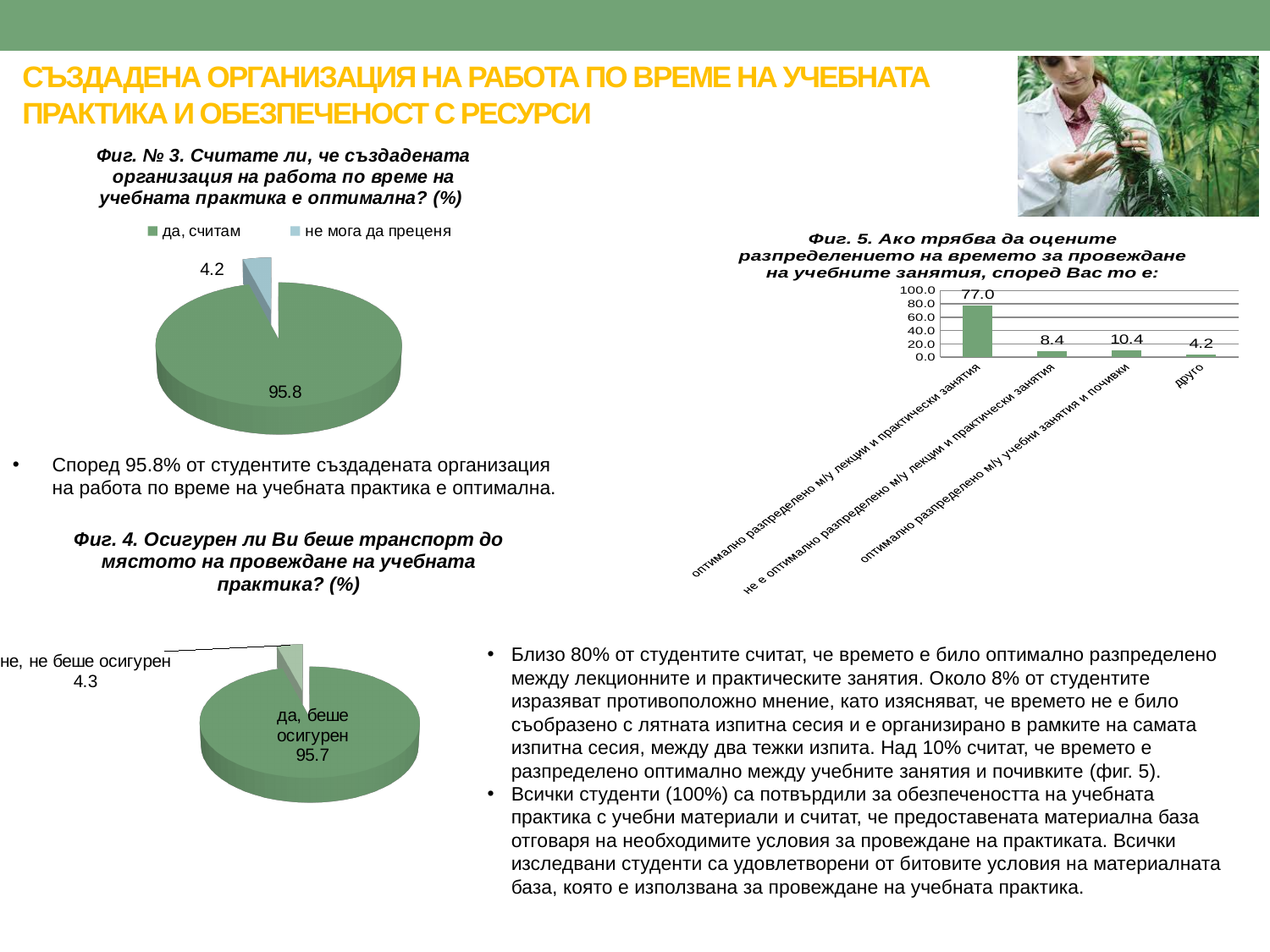
In the Fig. 3 pie chart, what is the value for "да, считам"? 95.8 In the Fig. 5 chart, which category has the highest value? оптимално разпределено м/у лекции и практически занятия How many categories are shown in the Fig. 5 bar chart? 4 What kind of chart is Fig. 4? Pie chart How many entries does the legend of the Fig. 3 pie chart list? 2 In the Fig. 4 pie chart, what is the value for "да, беше осигурен"? 95.7 In the Fig. 4 pie chart, what is the value for "не, не беше осигурен"? 4.3 In the Fig. 5 chart, what is the difference between the values for "оптимално разпределено м/у учебни занятия и почивки" and "не е оптимално разпределено м/у лекции и практически занятия"? 2.0 In the Fig. 5 chart, what is the value for "оптимално разпределено м/у учебни занятия и почивки"? 10.4 In the Fig. 5 chart, what is the value for "друго"? 4.2 In the Fig. 5 chart, which category has the lowest value? друго In the Fig. 3 pie chart, what is the value for "не мога да преценя"? 4.2